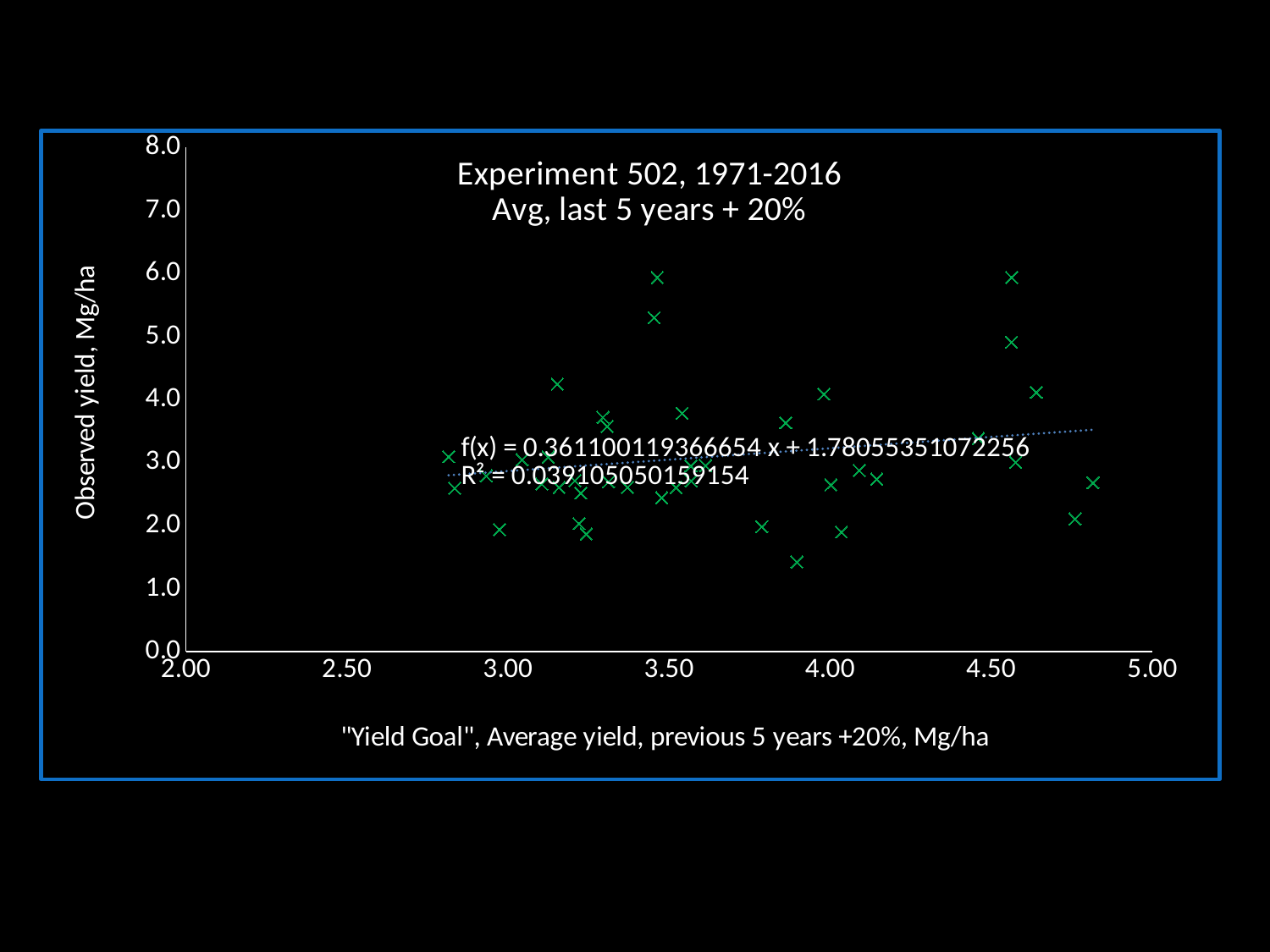
Is the highest observed yield plotted on the chart greater or less than 5.0? greater What is the title of the chart? Experiment 502, 1971-2016 Avg, last 5 years + 20% What R² value is printed on the chart? 0.039105050159154 What is the lowest value shown on the horizontal axis? 2.00 Is the lowest observed yield plotted on the chart greater or less than 2.0? less What is the highest value shown on the vertical axis? 8.0 What is the label of the vertical axis? Observed yield, Mg/ha Is the R² value printed on the chart greater or less than 0.1? less What is the intercept of the trendline equation printed on the chart? 1.78055351072256 Does the trendline rise or fall as the yield goal increases along the x axis? rises What kind of chart is shown on the slide? scatter chart What is the slope of the trendline equation printed on the chart? 0.361100119366654